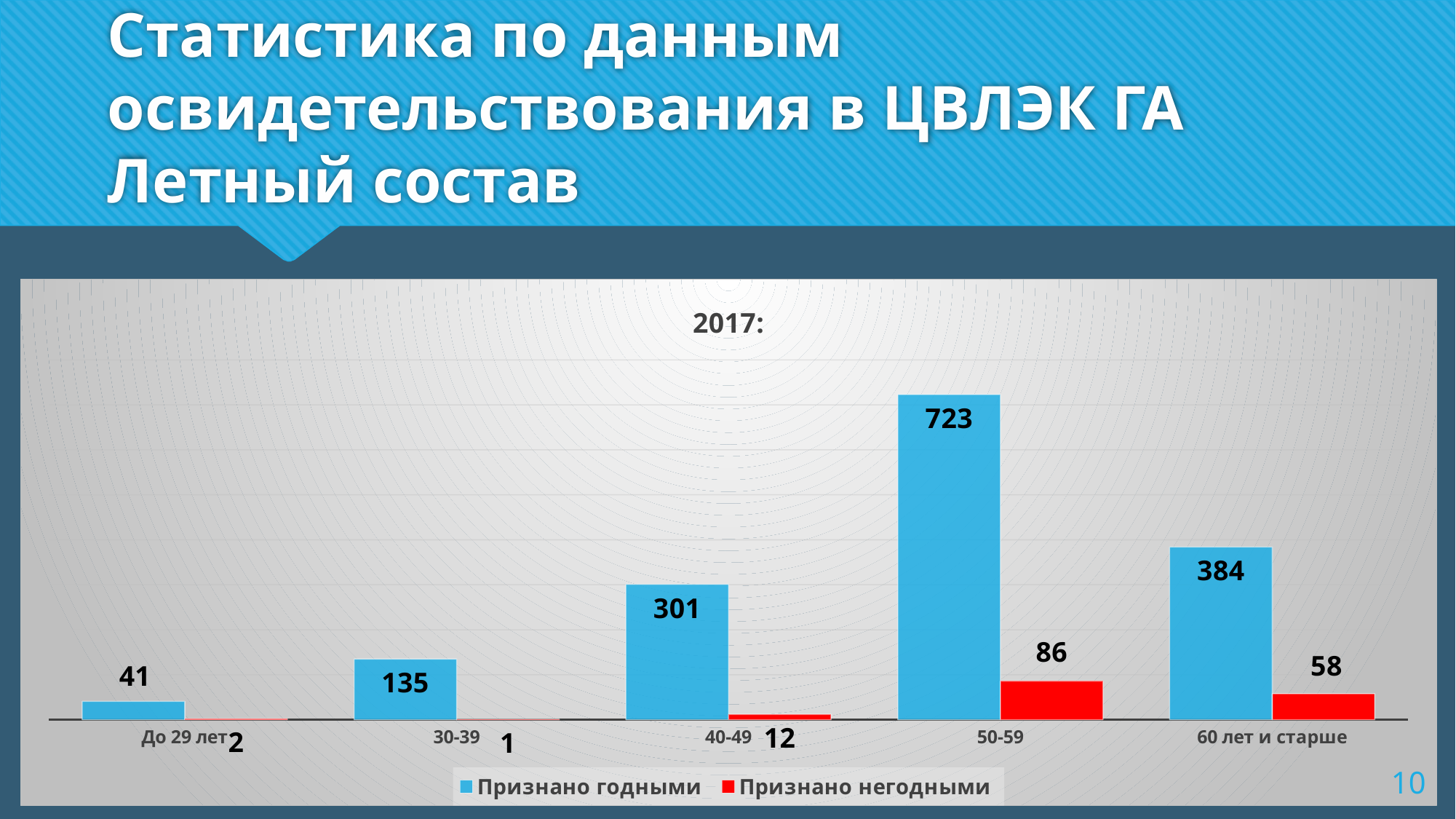
Which age group has the lowest value for 'Признано негодными'? 30-39 What is the value of 'Признано годными' for the 50-59 age group? 723 Which is larger: 'Признано негодными' for 50-59 or for 60 лет и старше? 50-59 How many age groups are shown on the x axis? 5 What kind of chart is shown on the slide? Bar chart What year is shown as the chart title? 2017 How many series does the legend list? 2 What is the value of 'Признано негодными' for the 40-49 age group? 12 Which age group has the highest value for 'Признано годными'? 50-59 What is the value of 'Признано негодными' for the '60 лет и старше' age group? 58 What is the difference between 'Признано годными' for 50-59 and for 60 лет и старше? 339 What is the value of 'Признано годными' for the 'До 29 лет' age group? 41